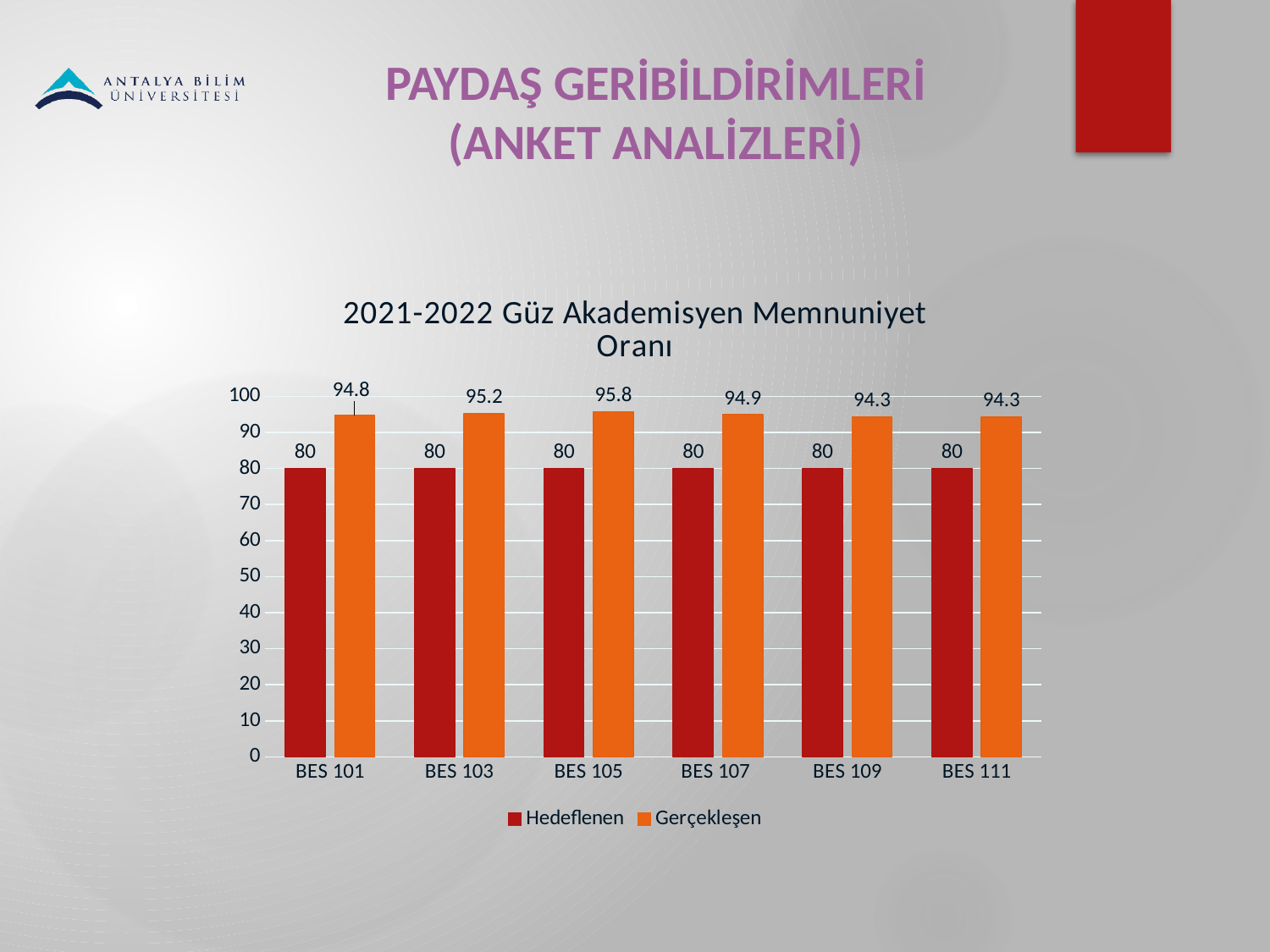
How many series does the legend list? 2 What is the Hedeflenen value for BES 107? 80 What is the title of the chart? 2021-2022 Güz Akademisyen Memnuniyet Oranı What is the Gerçekleşen value for BES 101? 94.8 Which course has the highest Gerçekleşen value? BES 105 Which is larger for BES 109: the Hedeflenen value or the Gerçekleşen value? Gerçekleşen What is the difference between the Gerçekleşen and Hedeflenen values for BES 103? 15.2 What is the Gerçekleşen value for BES 105? 95.8 What kind of chart is shown on the slide? bar chart How many courses are shown on the x axis? 6 Which colour represents the Gerçekleşen series? orange Is the Gerçekleşen value for BES 111 greater or less than 90? greater